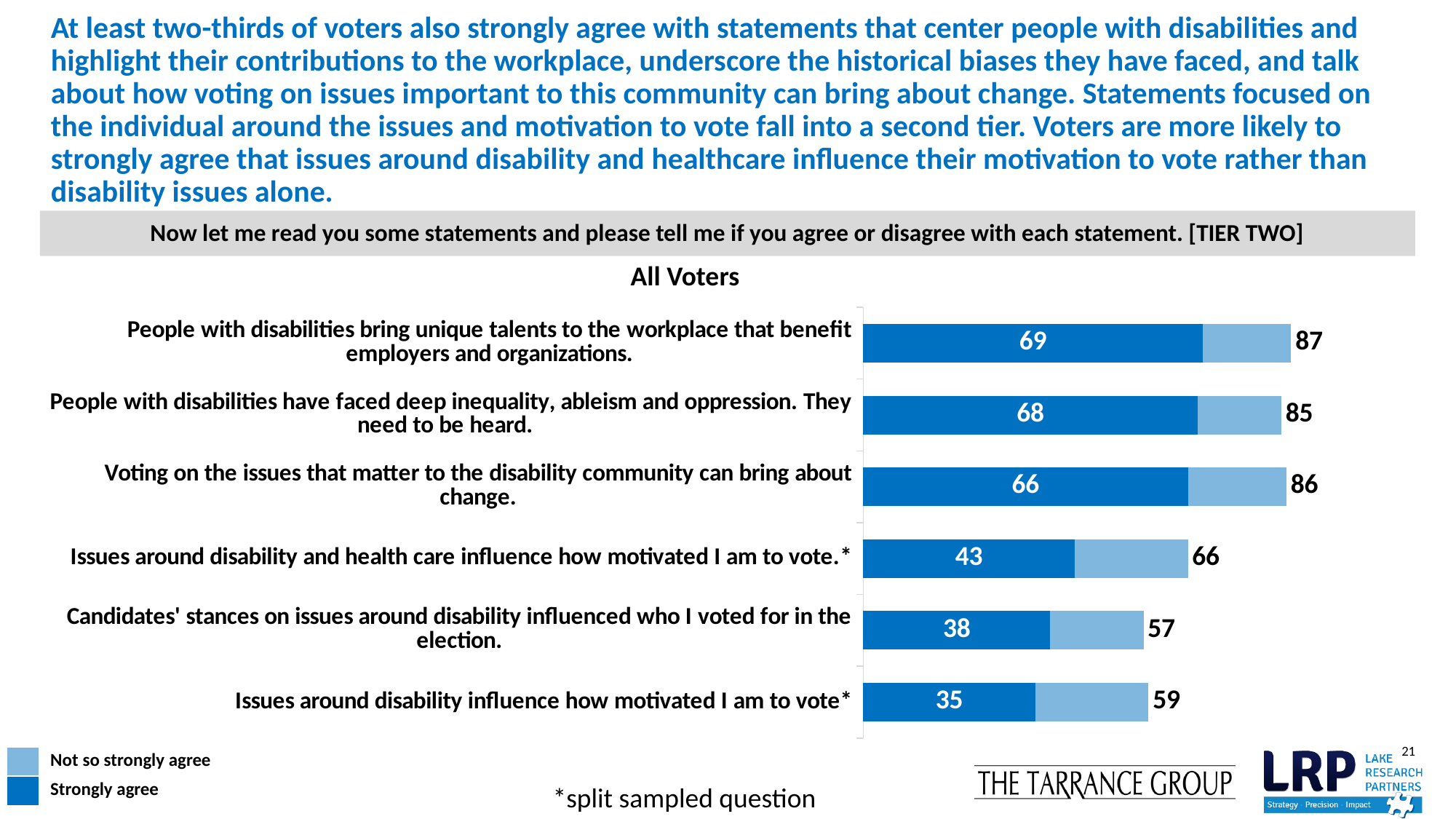
What is the difference in strongly agree values between 'People with disabilities have faced deep inequality, ableism and oppression. They need to be heard.' and 'Candidates' stances on issues around disability influenced who I voted for in the election.'? 30 What is the title shown above the chart? All Voters What percentage of all voters strongly agree that people with disabilities bring unique talents to the workplace that benefit employers and organizations? 69 What is the total agreement shown for the statement 'Voting on the issues that matter to the disability community can bring about change.'? 86 Which statement has the highest strongly agree value? People with disabilities bring unique talents to the workplace that benefit employers and organizations. What is the strongly agree value for 'Issues around disability influence how motivated I am to vote'? 35 How many series does the legend list? 2 What kind of chart is shown on the slide? Stacked bar chart Which statement has the lowest total agreement? Candidates' stances on issues around disability influenced who I voted for in the election. Which has a higher strongly agree value: 'Issues around disability and health care influence how motivated I am to vote' or 'Issues around disability influence how motivated I am to vote'? Issues around disability and health care influence how motivated I am to vote What is the difference between the total agreement and the strongly agree value for 'People with disabilities bring unique talents to the workplace that benefit employers and organizations.'? 18 How many statements are shown in the chart? 6